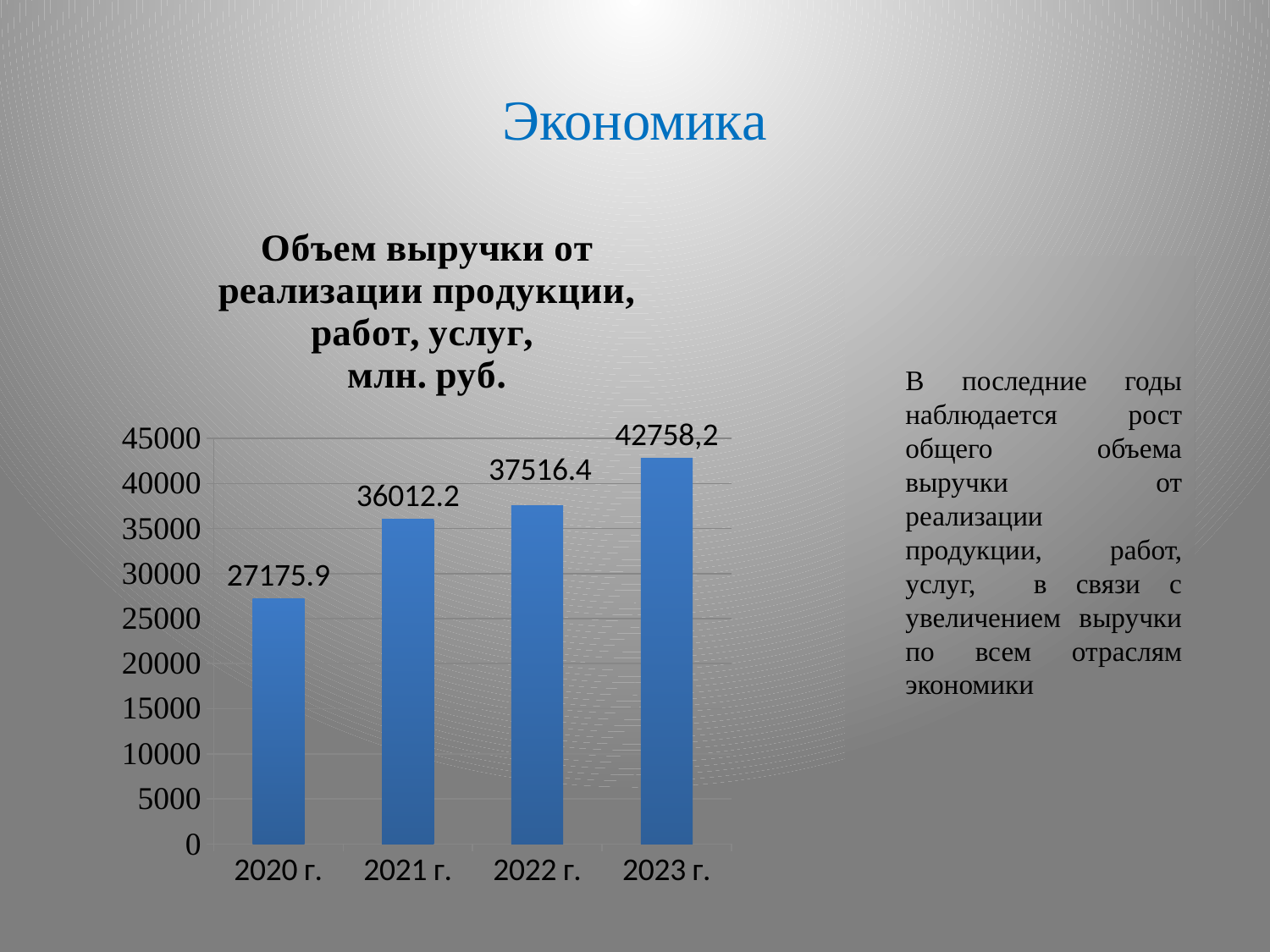
What is the value for 2023 г.? 42758,2 What is the difference between the values for 2021 г. and 2020 г.? 8836.3 Do the values rise or fall from 2020 г. to 2023 г.? rise Is the value for 2020 г. greater or less than 30000? less Which year has the highest value? 2023 г. How many years are shown on the chart? 4 What is the value for 2021 г.? 36012.2 Which year has the lowest value? 2020 г. What is the value for 2022 г.? 37516.4 What is the difference between the values for 2023 г. and 2022 г.? 5241.8 Which is larger, the value for 2022 г. or the value for 2021 г.? 2022 г. What is the value for 2020 г.? 27175.9